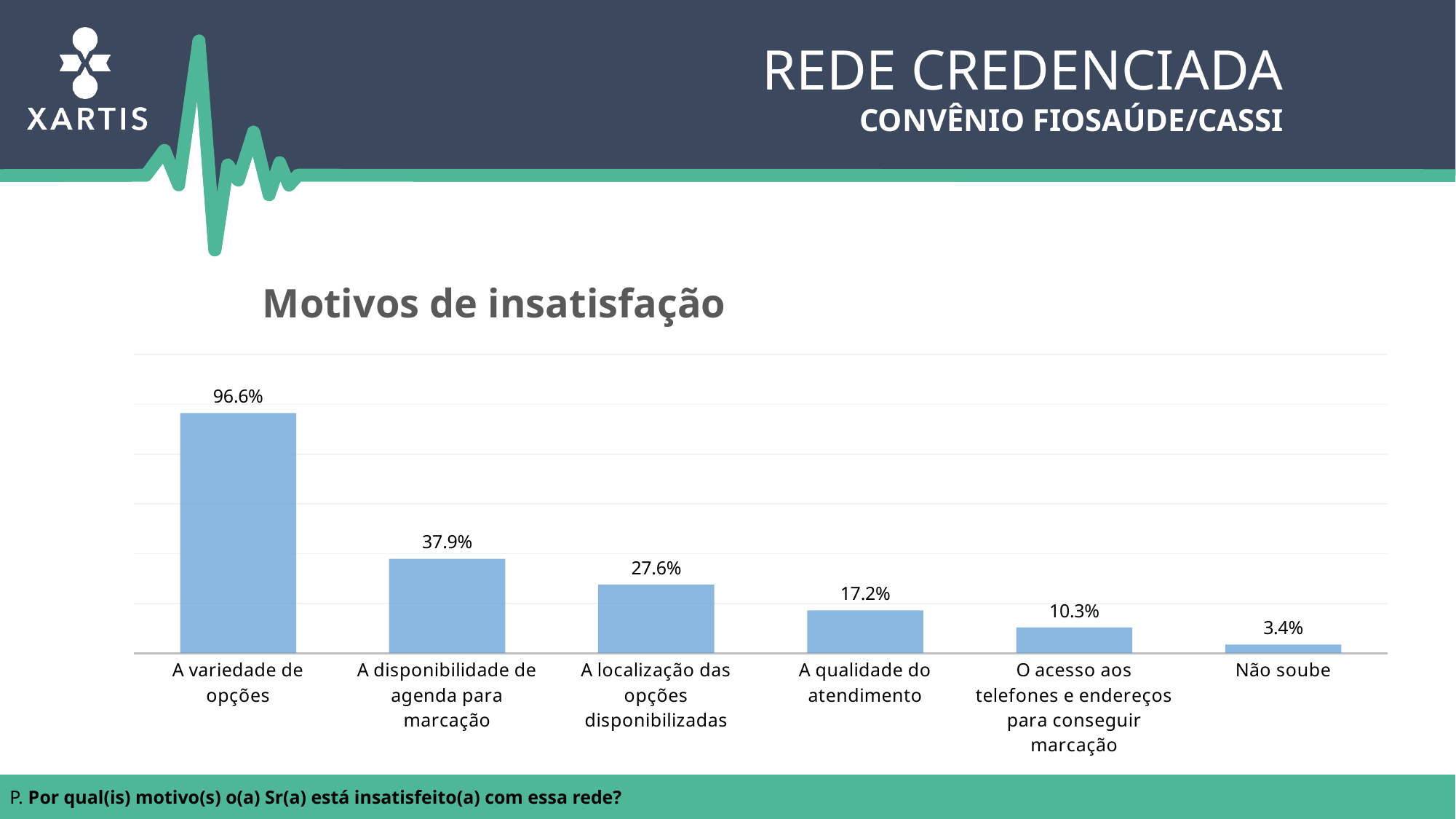
Which category has the highest value? A variedade de opções What is the value for "Não soube"? 3.4% What is the title of the chart? Motivos de insatisfação What is the difference between the values for "A variedade de opções" and "A disponibilidade de agenda para marcação"? 58.7% Which is larger: the value for "A qualidade do atendimento" or the value for "O acesso aos telefones e endereços para conseguir marcação"? A qualidade do atendimento How many categories are shown in the chart? 6 What is the value for "A variedade de opções"? 96.6% What is the value for "A localização das opções disponibilizadas"? 27.6% What is the value for "A qualidade do atendimento"? 17.2% Which category has the lowest value? Não soube What kind of chart is shown on the slide? Bar chart What is the value for "A disponibilidade de agenda para marcação"? 37.9%